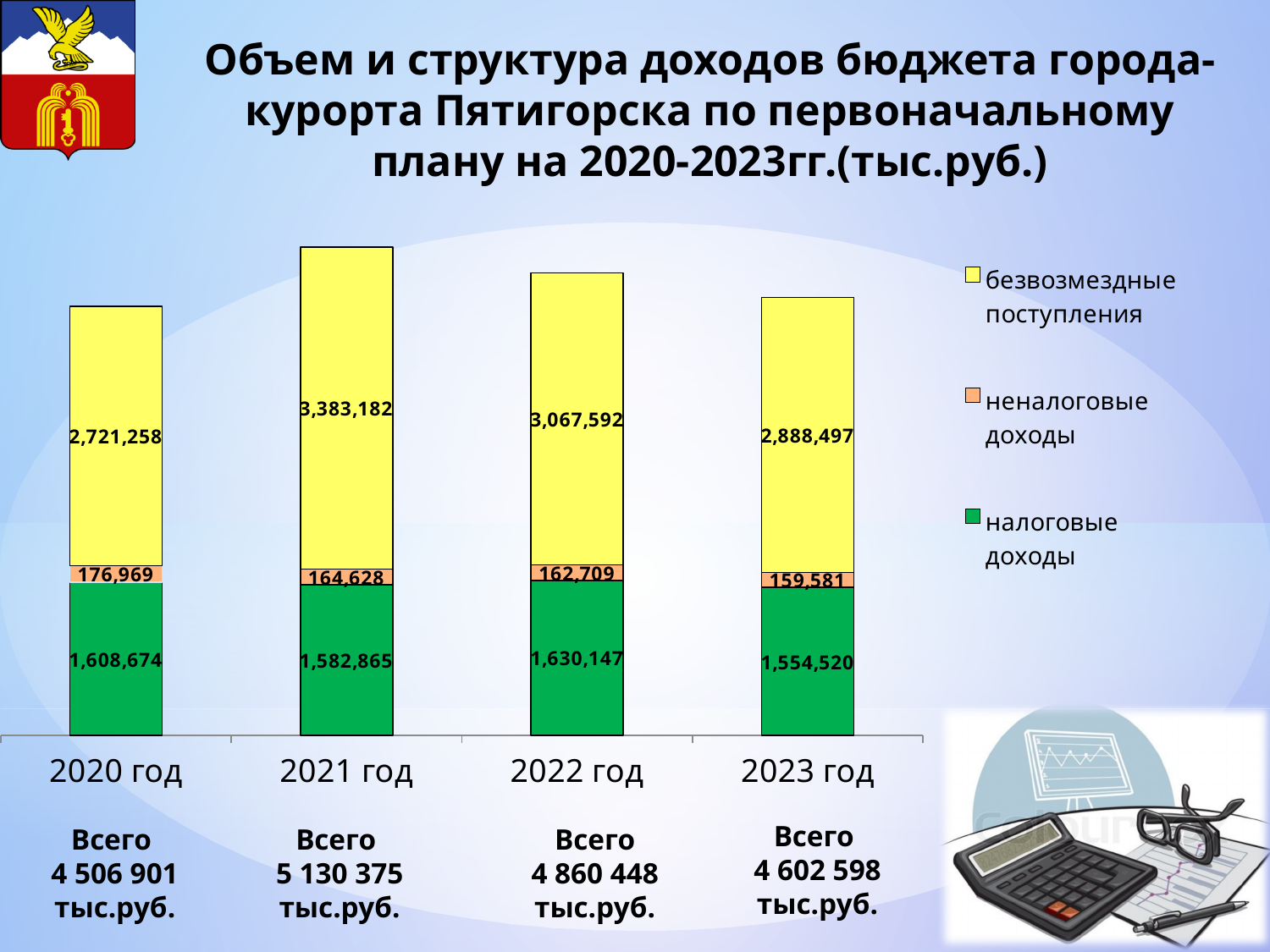
How many series does the legend list? 3 What is the value of безвозмездные поступления for 2021 год? 3,383,182 In which year is the value of неналоговые доходы the highest? 2020 год In which year is the value of налоговые доходы the lowest? 2023 год What is the value of неналоговые доходы for 2023 год? 159,581 What is the difference between безвозмездные поступления in 2021 год and in 2020 год? 661,924 What is the total (Всего) of the stacked bar for 2021 год? 5 130 375 тыс.руб. Which is larger: налоговые доходы in 2022 год or in 2020 год? 2022 год How many years (categories) are shown on the x axis? 4 What type of chart is shown on the slide? stacked bar chart What is the value of налоговые доходы for 2022 год? 1,630,147 In which year is the value of безвозмездные поступления the highest? 2021 год